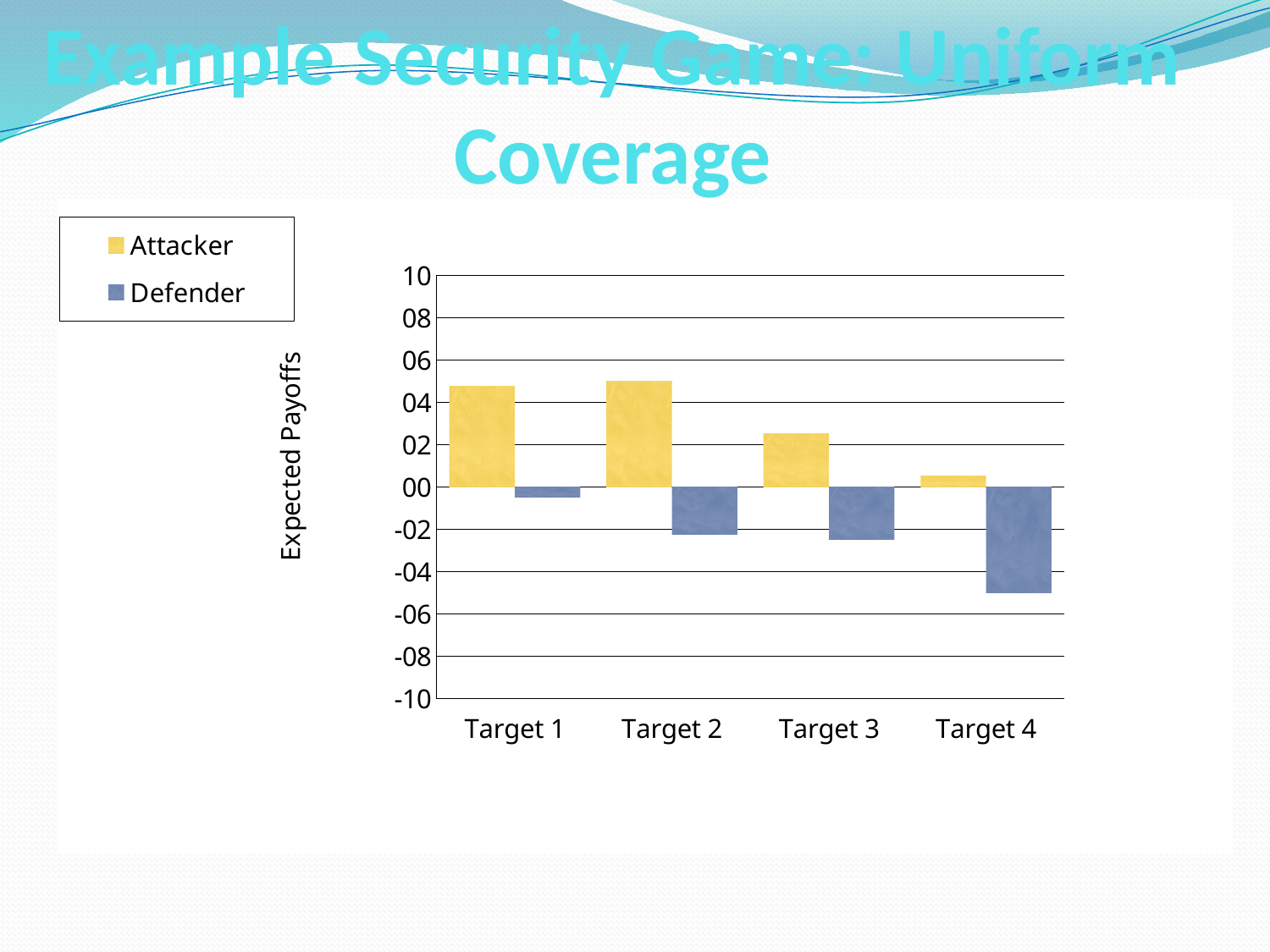
Is the Attacker value for Target 4 greater or less than 02? less Which target has the lowest Defender expected payoff? Target 4 Which target has the lowest Attacker expected payoff? Target 4 Is the Attacker value for Target 1 greater or less than 04? greater What kind of chart is shown on the slide? bar chart Is the Attacker value for Target 3 greater or less than 02? greater How many targets are shown on the x axis? 4 Do the Attacker values rise or fall from Target 1 to Target 4? fall Which is larger, the Attacker value for Target 1 or for Target 3? Target 1 How many series does the legend list? 2